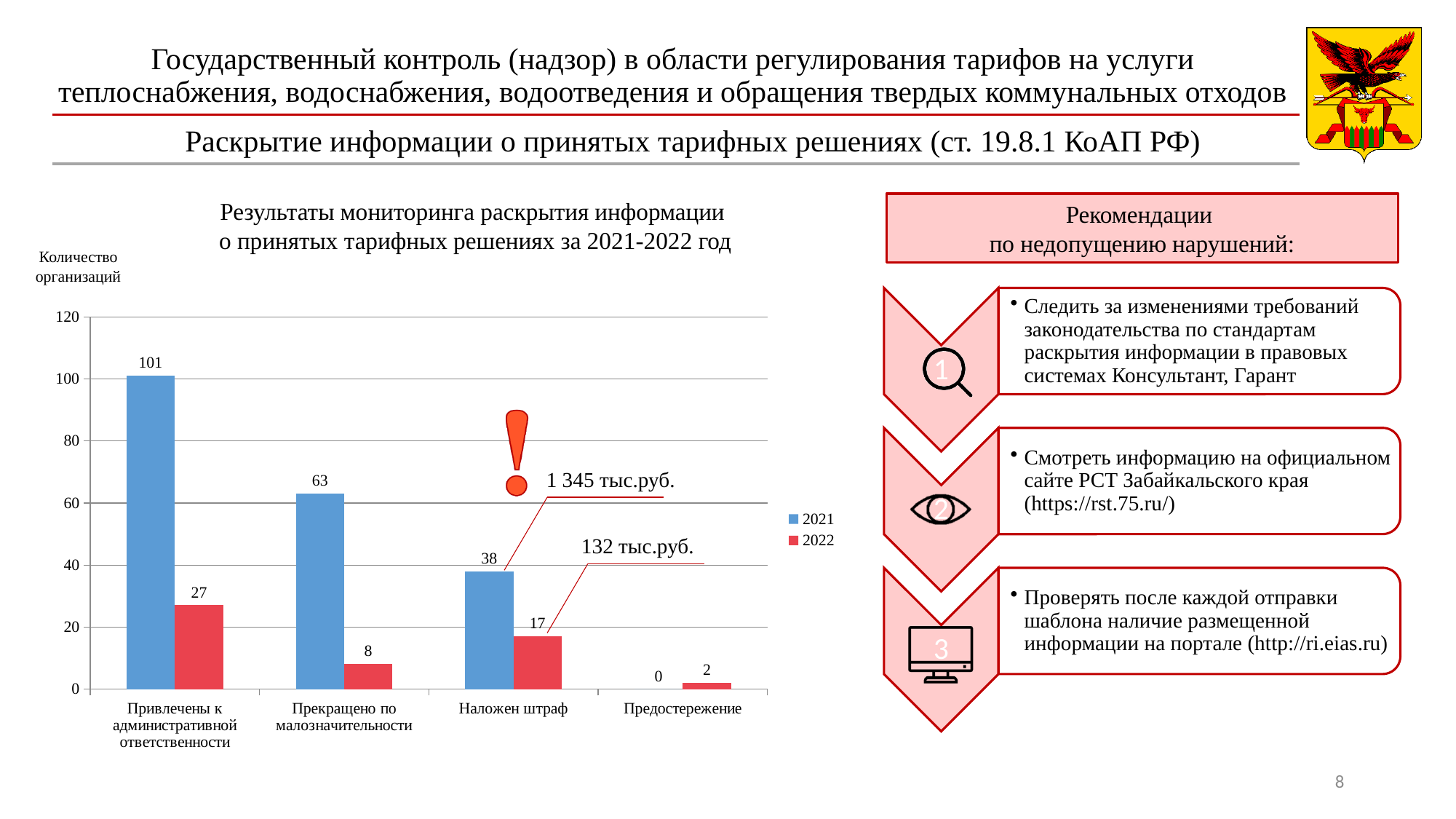
What type of chart is shown on the slide? bar chart What is the 2021 value for "Привлечены к административной ответственности"? 101 Which category has the lowest 2022 value? Предостережение Which is larger for "Наложен штраф": the 2021 value or the 2022 value? 2021 What is the difference between the 2021 and 2022 values for "Привлечены к административной ответственности"? 74 What is the 2022 value for "Наложен штраф"? 17 How many categories are shown on the x axis of the chart? 4 What is the 2021 value for "Предостережение"? 0 What is the 2022 value for "Прекращено по малозначительности"? 8 What is the title of the chart? Результаты мониторинга раскрытия информации о принятых тарифных решениях за 2021-2022 год How many series does the chart legend list? 2 Which category has the highest 2021 value? Привлечены к административной ответственности